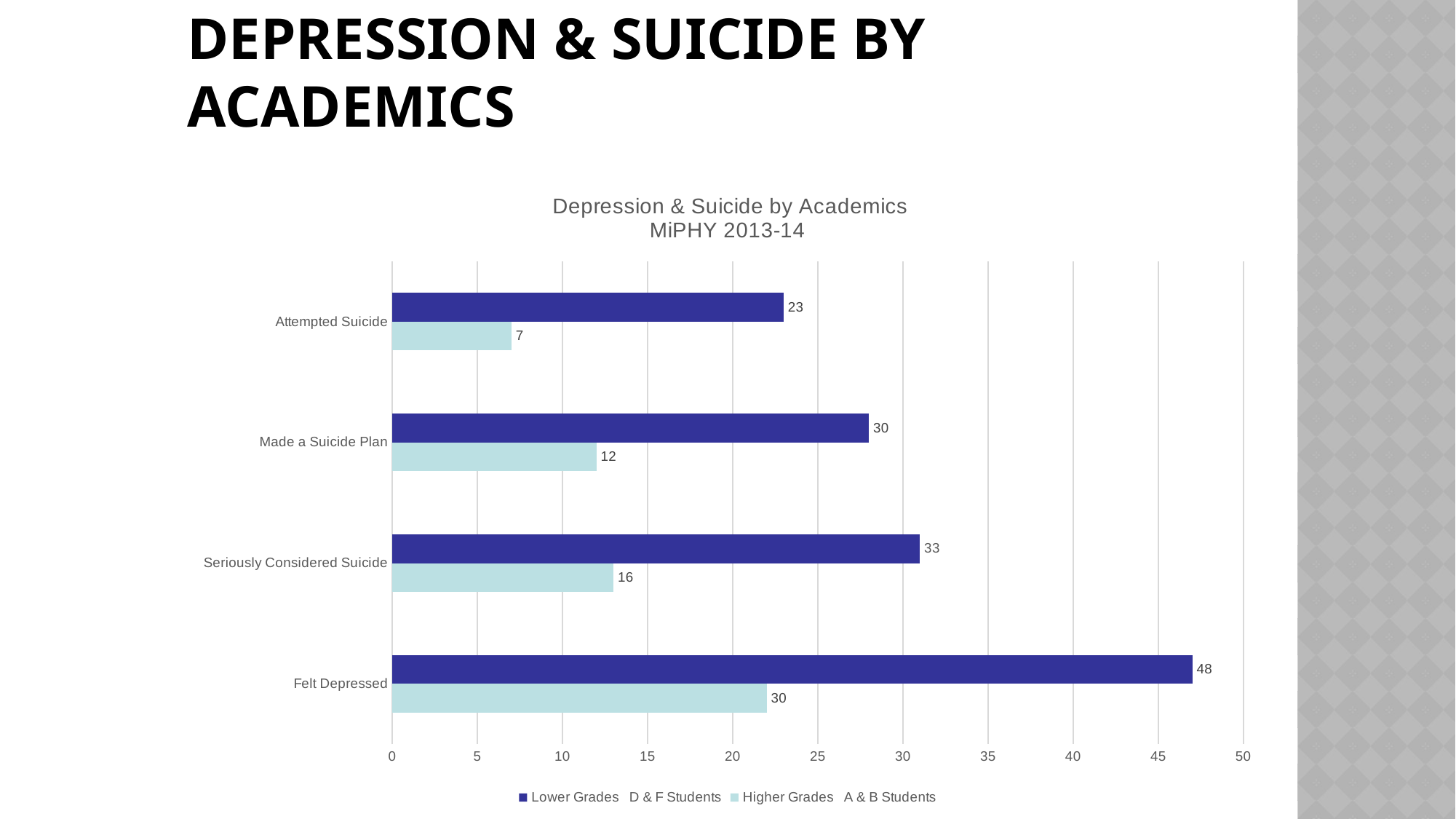
What is the difference between the Lower Grades D & F Students and Higher Grades A & B Students values for Felt Depressed? 18 What is the title of the chart? Depression & Suicide by Academics MiPHY 2013-14 What is the value for Higher Grades A & B Students for Seriously Considered Suicide? 16 How many series does the legend list? 2 What is the value for Higher Grades A & B Students for Attempted Suicide? 7 What is the value for Lower Grades D & F Students for Felt Depressed? 48 Which category has the lowest value for Higher Grades A & B Students? Attempted Suicide Which is larger for Made a Suicide Plan: the Lower Grades D & F Students value or the Higher Grades A & B Students value? Lower Grades D & F Students How many categories are shown on the chart? 4 What kind of chart is shown on the slide? bar chart What is the value for Lower Grades D & F Students for Made a Suicide Plan? 30 Which category has the highest value for Lower Grades D & F Students? Felt Depressed